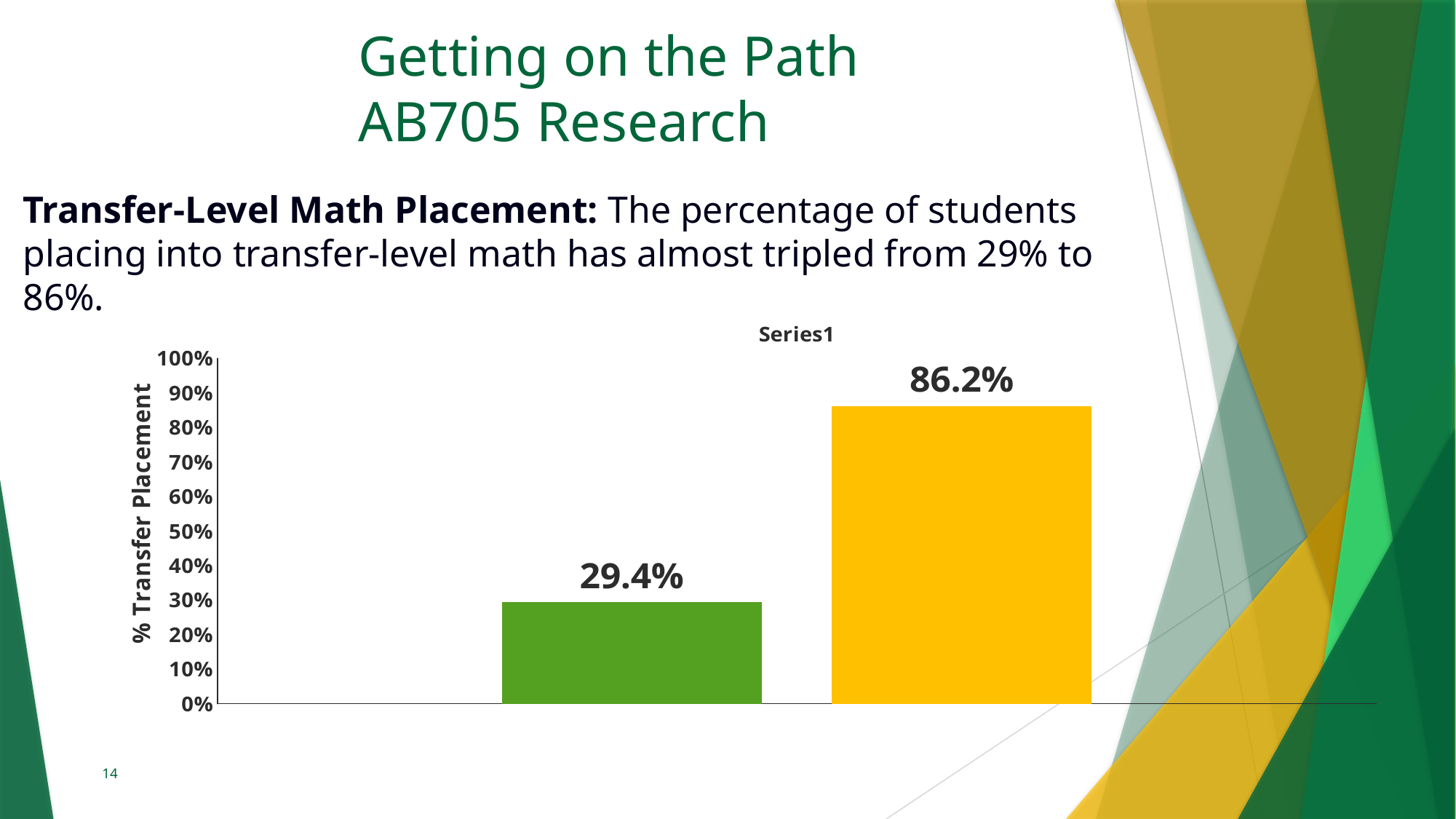
What is the value shown on the yellow bar (the right bar) in the chart? 86.2% How many bars are plotted in the chart? 2 What is the label on the vertical axis of the chart? % Transfer Placement Is the value of the yellow bar larger or smaller than the value of the green bar? larger Which bar has the highest value, the left (green) bar or the right (yellow) bar? the right (yellow) bar What is the difference in percentage points between the right bar (86.2%) and the left bar (29.4%)? 56.8 Is the value for the left (green) bar greater or less than 50%? less What kind of chart is shown on the slide? bar chart Which bar has the lowest value, the left (green) bar or the right (yellow) bar? the left (green) bar Is the value for the right (yellow) bar greater or less than 80%? greater What is the value shown on the green bar (the left bar) in the chart? 29.4% Do the bar values rise or fall from left to right? rise